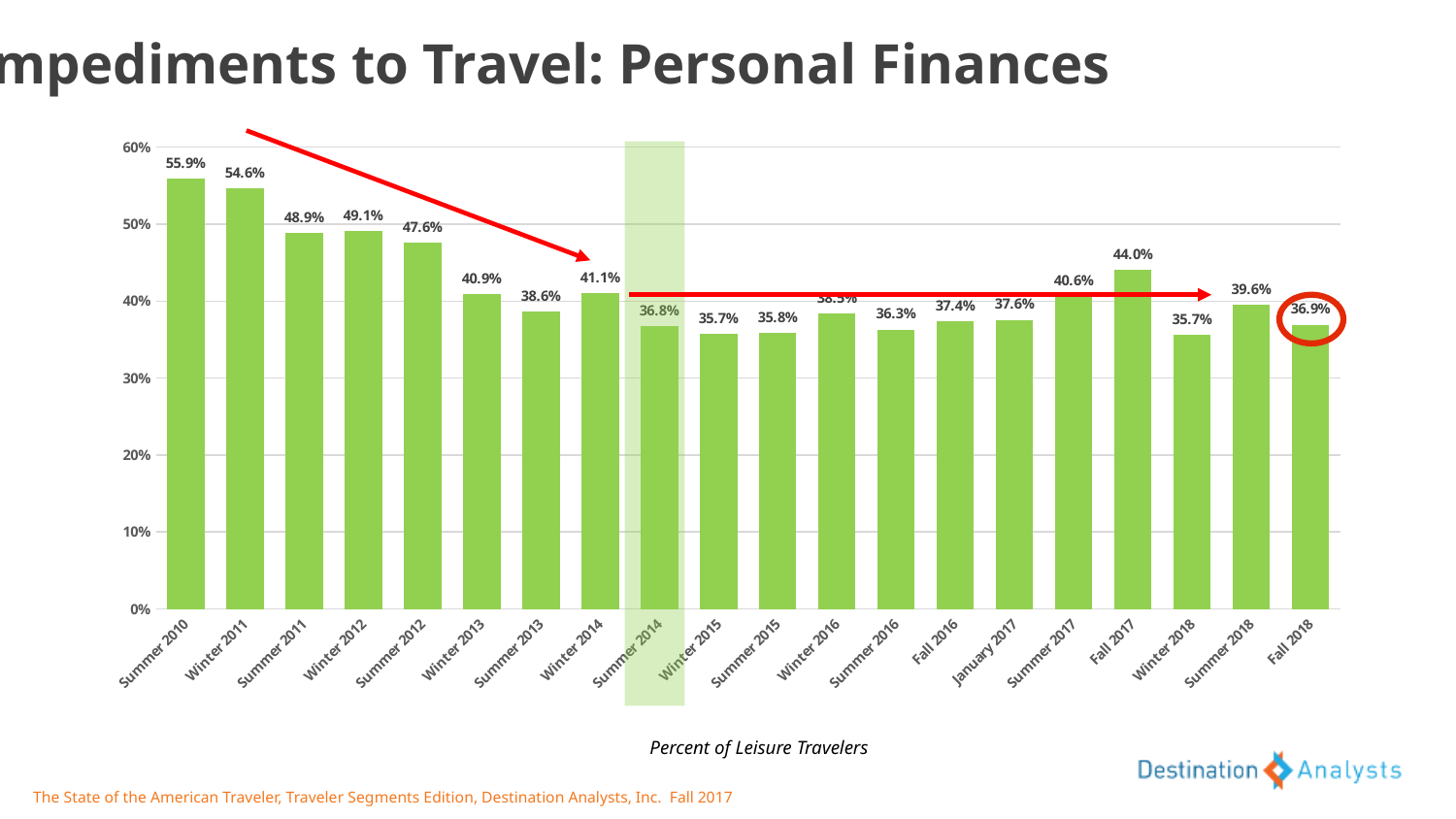
What is the value for Winter 2012? 49.1% What is the value for Summer 2010? 55.9% What is the value for Fall 2017? 44.0% Overall, do the values rise or fall from Summer 2010 to Fall 2018? fall Which period has the highest value? Summer 2010 How many periods (bars) are shown on the chart? 20 What is the value for Fall 2018, the circled bar? 36.9% Is the value for Winter 2013 greater or less than 40%? greater What is the difference between the values for Fall 2017 and Winter 2018? 8.3 percentage points What kind of chart is shown on the slide? bar chart What is the difference between the values for Summer 2010 and Fall 2018? 19.0 percentage points Which is larger, the value for Fall 2017 or the value for Summer 2018? Fall 2017